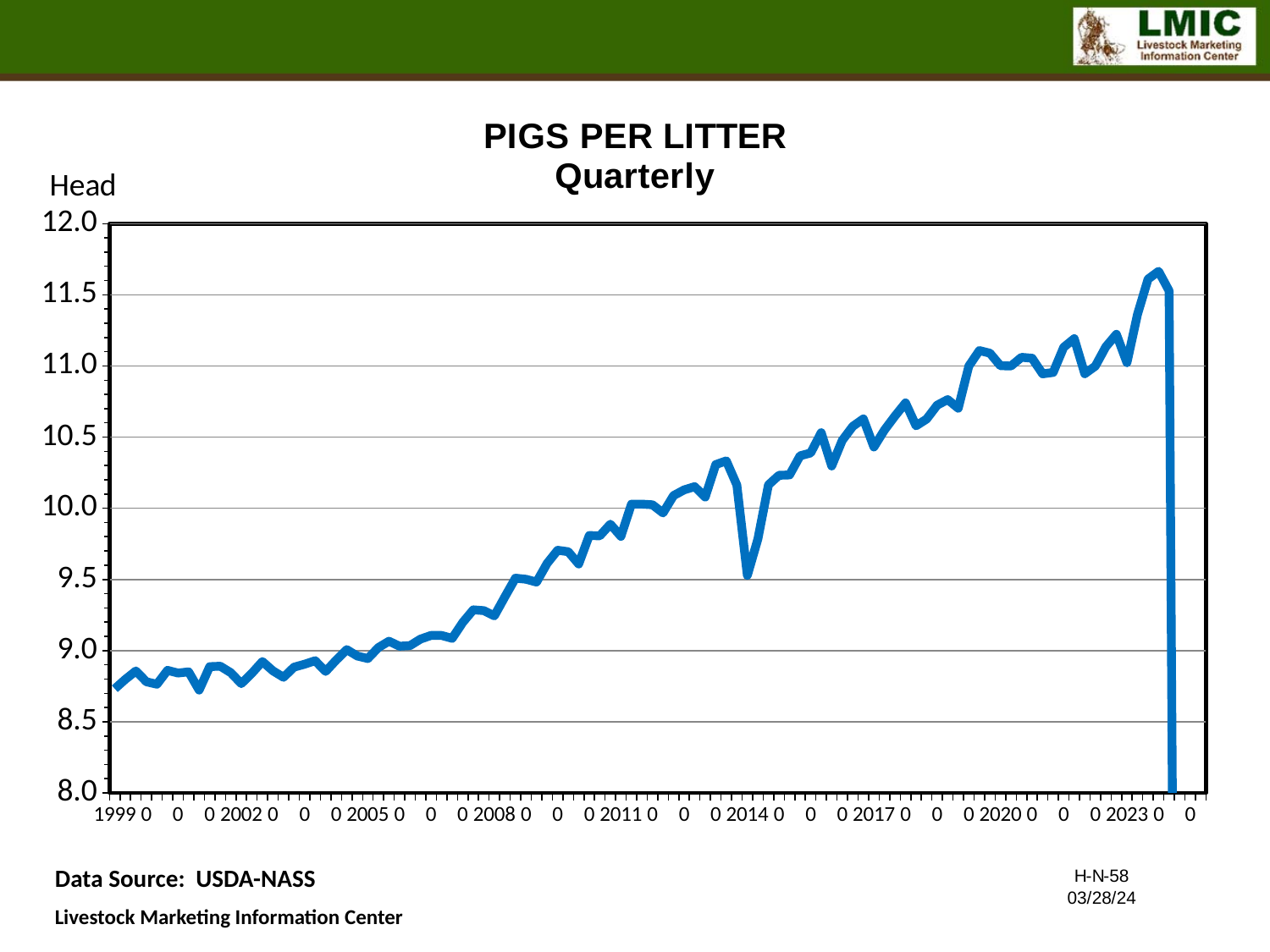
Which is larger, the value at 2023 or the value at 1999? 2023 Is the value at 2020 greater or less than 10.5? greater Is the highest point on the line greater or less than 11.5? greater Overall, do the values rise or fall from 1999 to 2023? rise Is the value at 2002 greater or less than 9.0? less What is the title of the chart? PIGS PER LITTER Quarterly What label is shown on the vertical axis of the chart? Head What kind of chart is shown on the slide? line chart